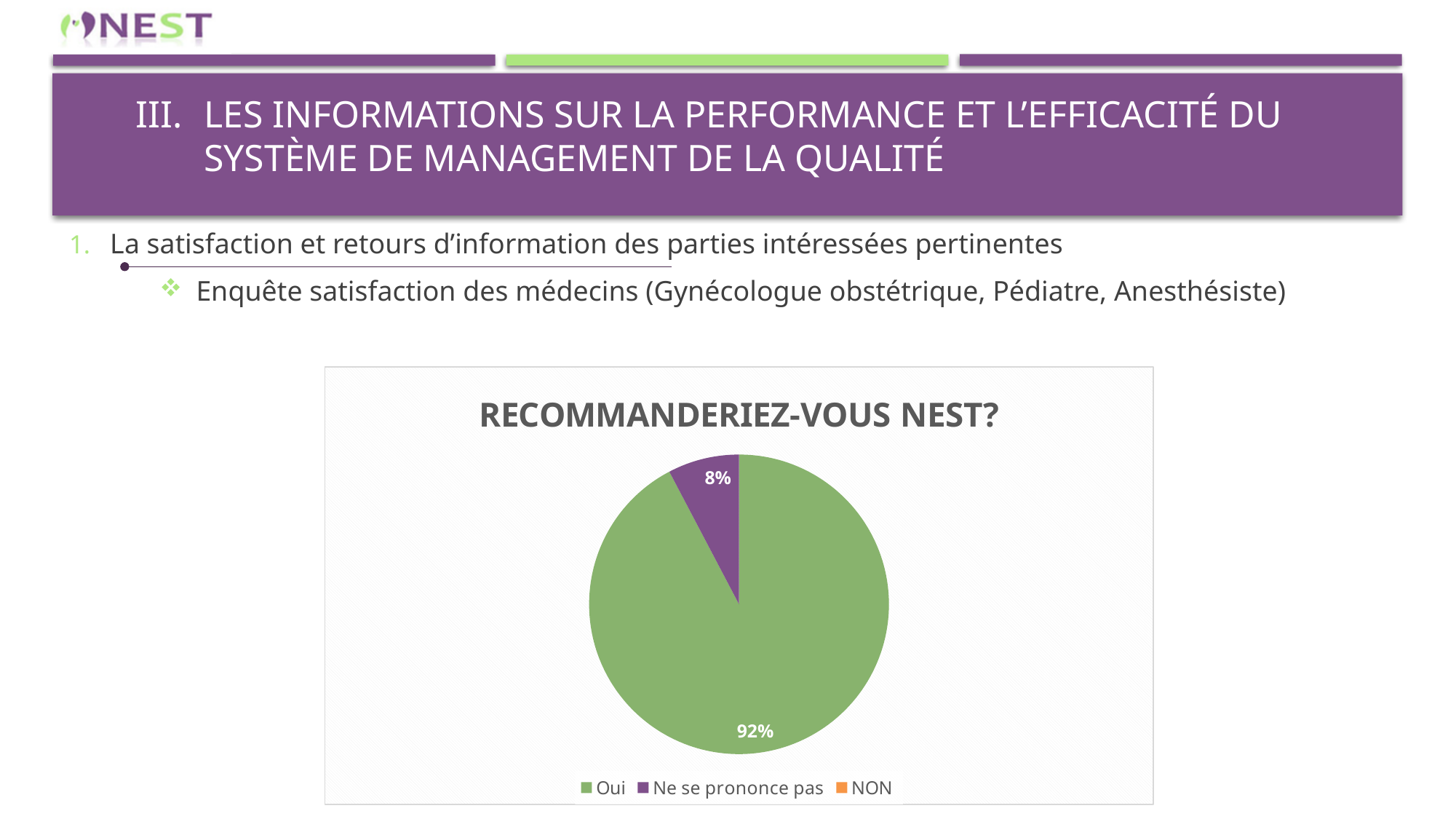
What share of the pie is labelled "Ne se prononce pas"? 8% What share of the pie is labelled "Oui"? 92% Which category has the largest slice of the pie? Oui What is the title of the chart? RECOMMANDERIEZ-VOUS NEST? Which is larger, the "Oui" slice or the "Ne se prononce pas" slice? Oui What kind of chart is shown on the slide? pie chart How many entries does the legend list? 3 Is the value for "Oui" greater or less than 50%? greater What is the difference in percentage points between the "Oui" slice and the "Ne se prononce pas" slice? 84 What colour is the "Oui" slice? green Which legend entry has no visible slice in the pie? NON